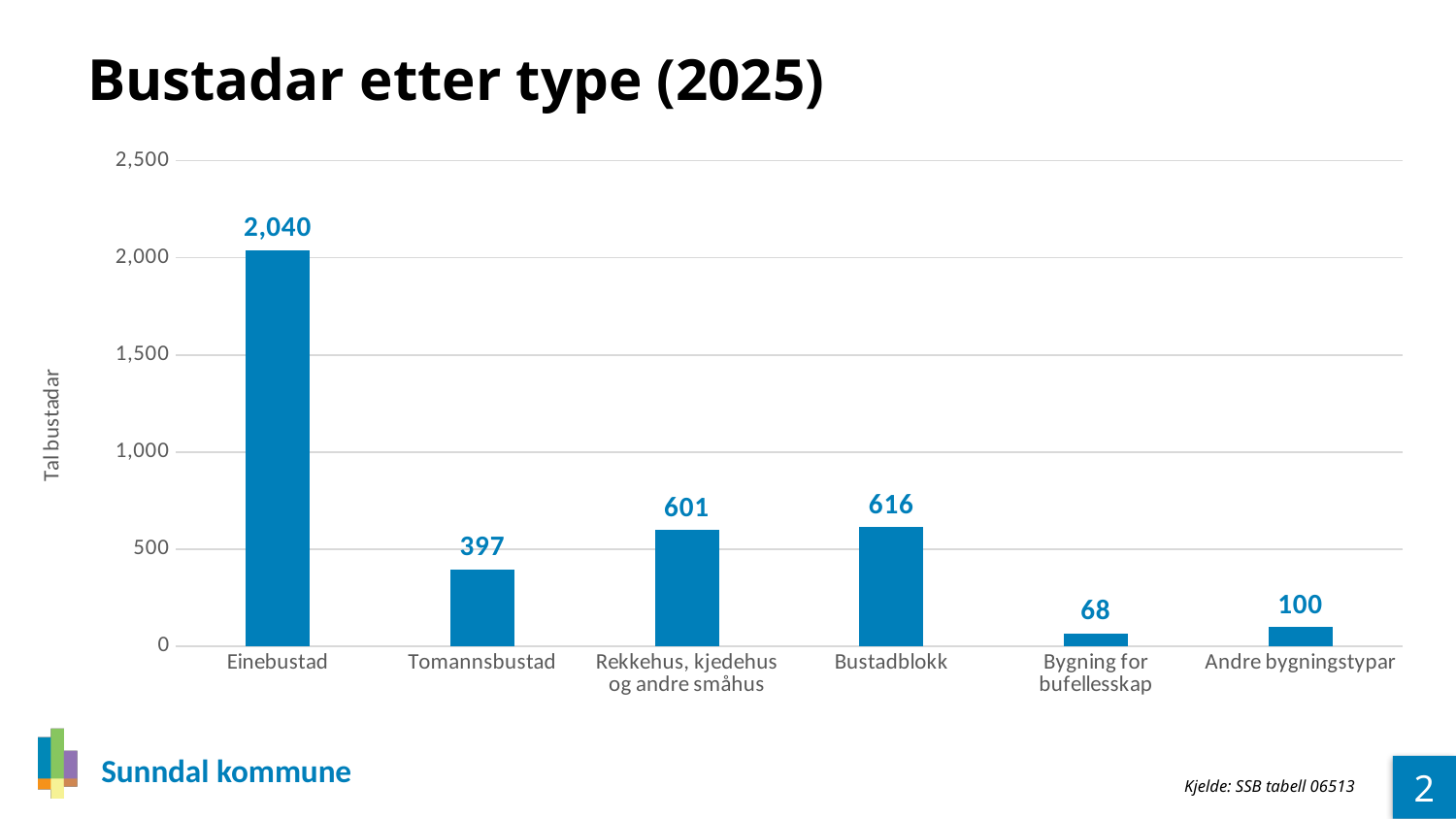
What is the value for Bustadblokk? 616 What kind of chart is this? Bar chart What is the value for Einebustad? 2,040 Which category has the highest value? Einebustad What is the title of the chart? Bustadar etter type (2025) What is the value for Tomannsbustad? 397 Which category has the lowest value? Bygning for bufellesskap What is the value for Bygning for bufellesskap? 68 What is the difference between the values for Andre bygningstypar and Bygning for bufellesskap? 32 How many categories are shown on the x axis? 6 What is the difference between the values for Einebustad and Tomannsbustad? 1,643 Which is larger, the value for Rekkehus, kjedehus og andre småhus or the value for Tomannsbustad? Rekkehus, kjedehus og andre småhus